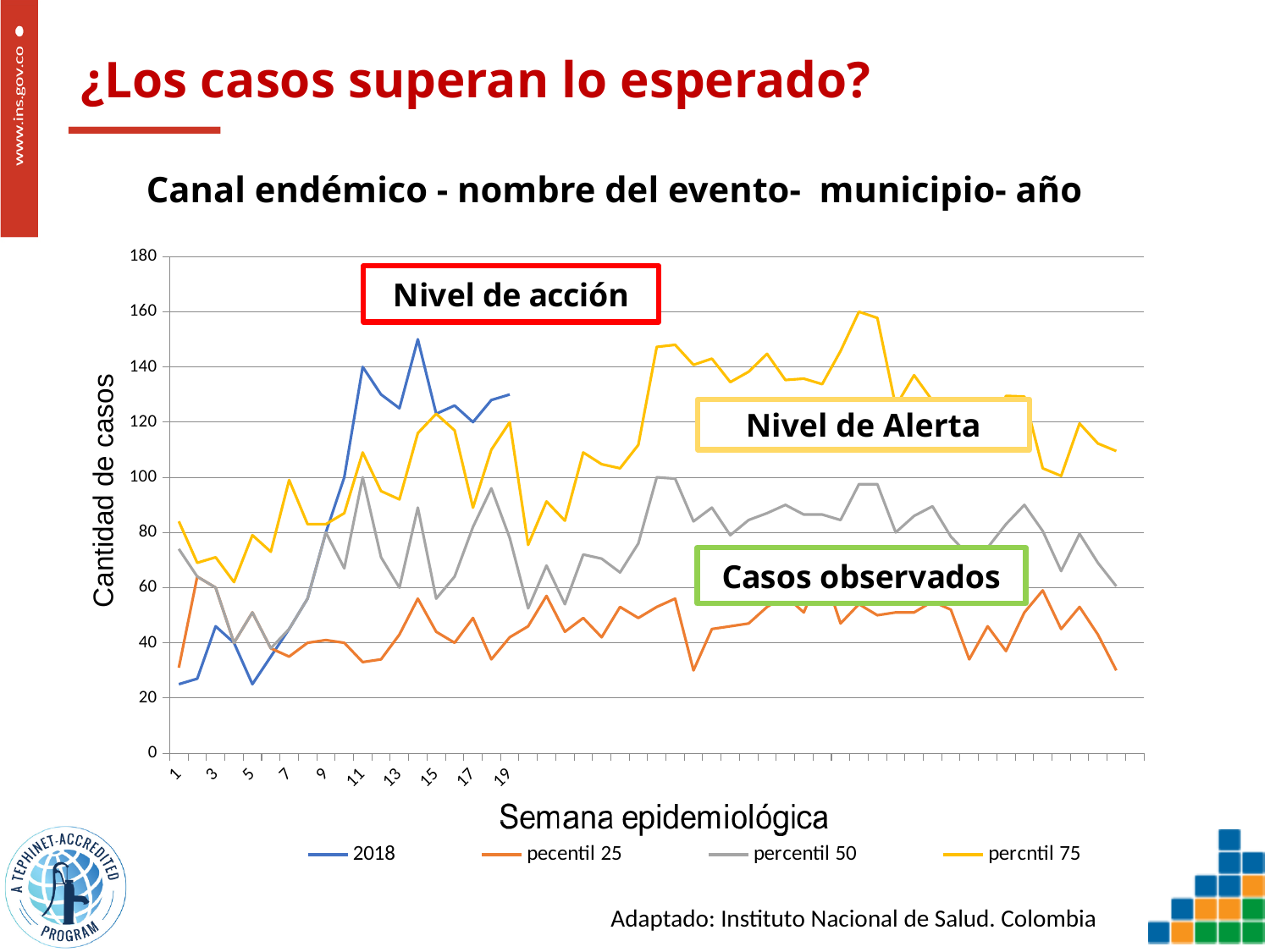
Is the value of the percntil 75 series at week 1 greater or less than 60? greater Does the 2018 series overall rise or fall from week 1 to week 19? rise What kind of chart is shown on the slide? line chart At week 14, which is larger: the 2018 series or the percntil 75 series? 2018 At week 1, which is larger: the 2018 series or the percntil 75 series? percntil 75 Is the value of the pecentil 25 series at week 1 greater or less than 40? less Is the value of the 2018 series at week 14 greater or less than 140? greater What is the label of the vertical axis? Cantidad de casos How many series does the legend list? 4 What is the title of the chart? Canal endémico - nombre del evento- municipio- año Which series reaches the highest value anywhere on the chart? percntil 75